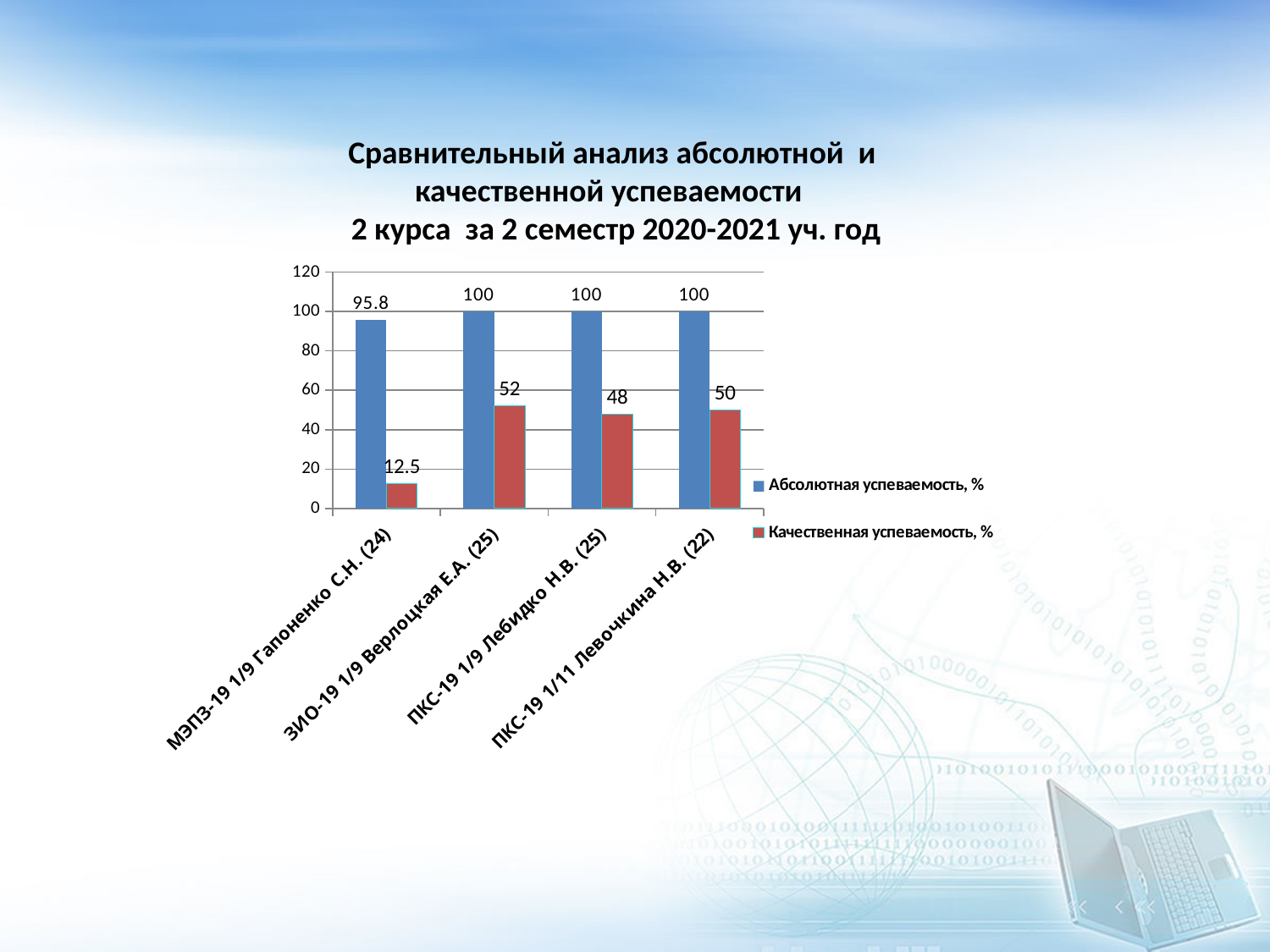
What is the Качественная успеваемость, % value for ПКС-19 1/11 Левочкина Н.В. (22)? 50 Which group has the lowest Качественная успеваемость, %? МЭПЗ-19 1/9 Гапоненко С.Н. (24) How many series does the legend list? 2 Which colour represents Качественная успеваемость, % in the legend? Red Which is larger: the Качественная успеваемость, % for ПКС-19 1/9 Лебидко Н.В. (25) or for ПКС-19 1/11 Левочкина Н.В. (22)? ПКС-19 1/11 Левочкина Н.В. (22) What is the Абсолютная успеваемость, % value for МЭПЗ-19 1/9 Гапоненко С.Н. (24)? 95.8 What kind of chart is shown on the slide? Bar chart What is the Качественная успеваемость, % value for ЗИО-19 1/9 Верлоцкая Е.А. (25)? 52 How many groups (categories) are shown on the x axis? 4 Which group has the highest Качественная успеваемость, %? ЗИО-19 1/9 Верлоцкая Е.А. (25) What is the difference between the Абсолютная and Качественная успеваемость values for ПКС-19 1/9 Лебидко Н.В. (25)? 52 What is the difference in Качественная успеваемость, % between ЗИО-19 1/9 Верлоцкая Е.А. (25) and МЭПЗ-19 1/9 Гапоненко С.Н. (24)? 39.5